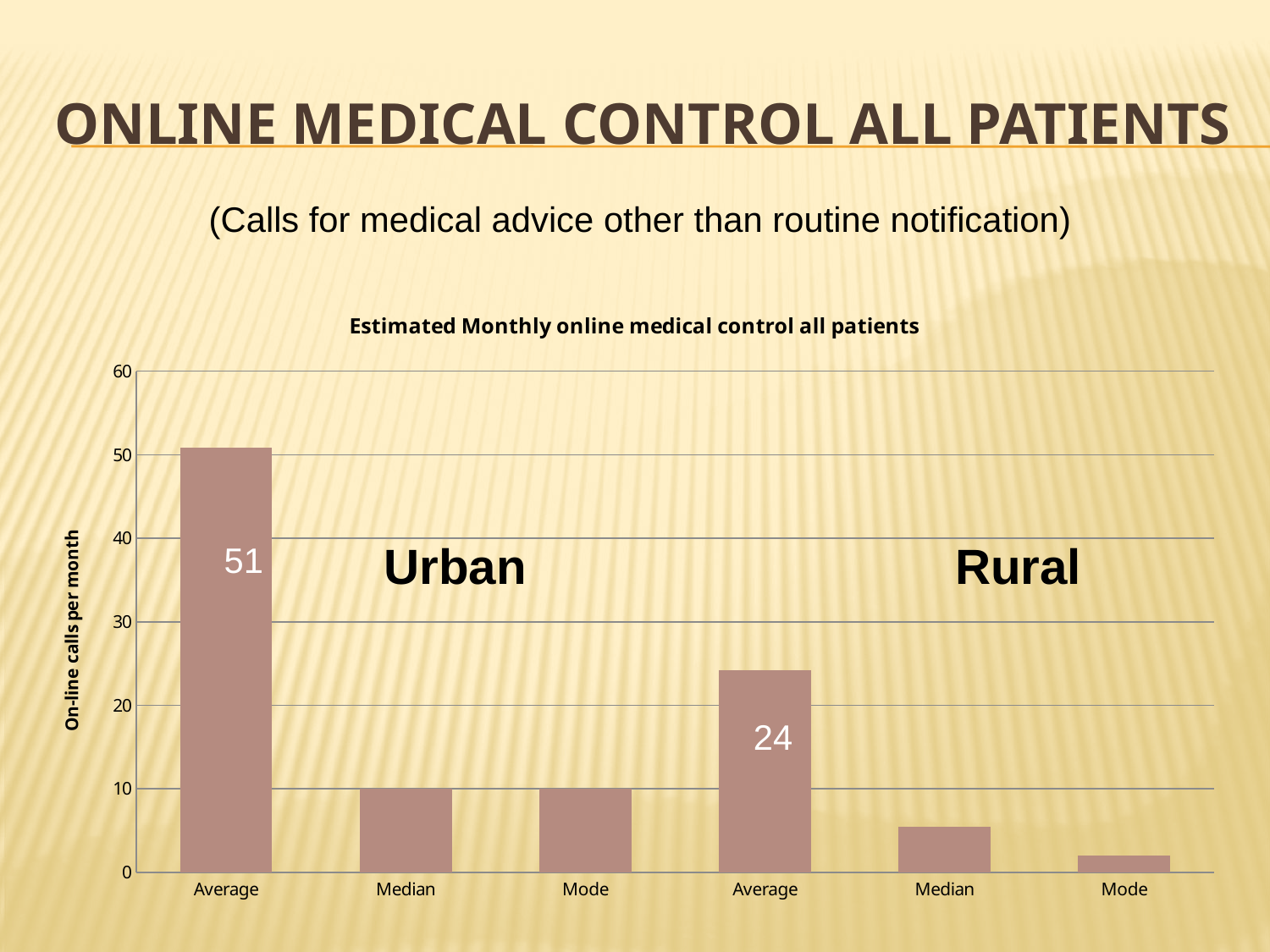
Is the value for Urban Average greater or less than 50? greater Which bar is the highest in the chart? Urban Average What is the difference between the Urban Average and the Rural Average values? 27 How many bars are plotted in the chart? 6 What is the value of the Rural Average bar? 24 What kind of chart is shown on the slide? bar chart Is the value for Rural Median greater or less than 10? less Which is larger, the Urban Average or the Rural Average? Urban Average Is the value for Rural Average greater or less than 20? greater Which bar is the lowest in the chart? Rural Mode What is the value of the Urban Average bar? 51 What is the label on the vertical axis of the chart? On-line calls per month